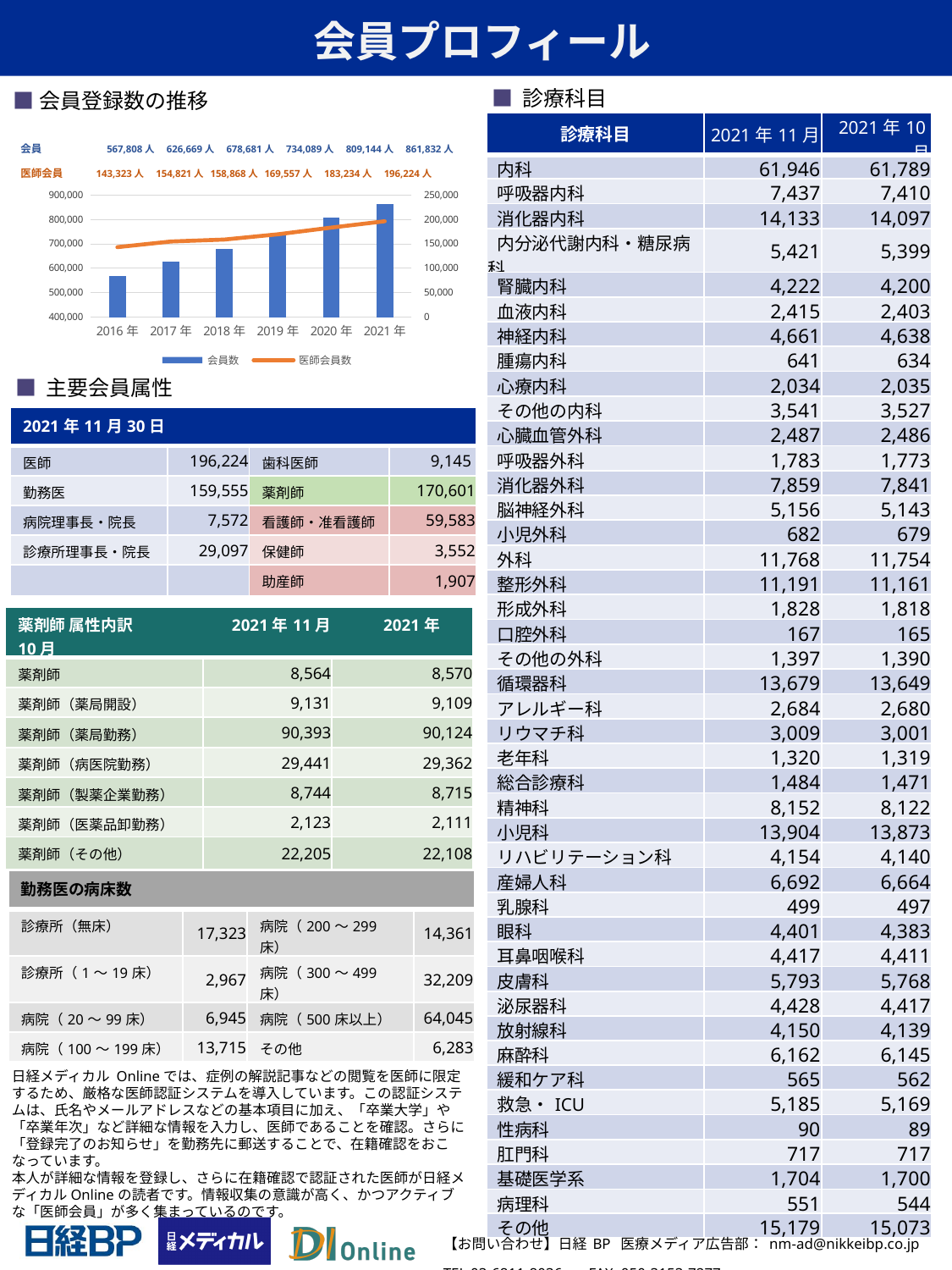
What kind of chart is shown under 会員登録数の推移? A combined bar and line chart How many series does the legend of the 会員登録数の推移 chart list? 2 How many years are shown on the x axis of the 会員登録数の推移 chart? 6 In the 会員登録数の推移 chart, what is the difference between the 会員 values for 2021年 and 2020年? 52,688人 In the 会員登録数の推移 chart, do the 会員数 values rise or fall from 2016年 to 2021年? Rise In the 会員登録数の推移 chart, which year has the highest 会員数? 2021年 In the 会員登録数の推移 chart, what is the 会員 value for 2018年? 678,681人 In the 会員登録数の推移 chart, is the 会員 value for 2019年 larger than the value for 2017年? Yes In the 会員登録数の推移 chart, is the 会員数 bar for 2016年 greater or less than 600,000? less In the 会員登録数の推移 chart, which year has the lowest 医師会員数? 2016年 In the 会員登録数の推移 chart, what is the 医師会員 value for 2016年? 143,323人 In the 会員登録数の推移 chart, what is the 会員 value for 2021年? 861,832人